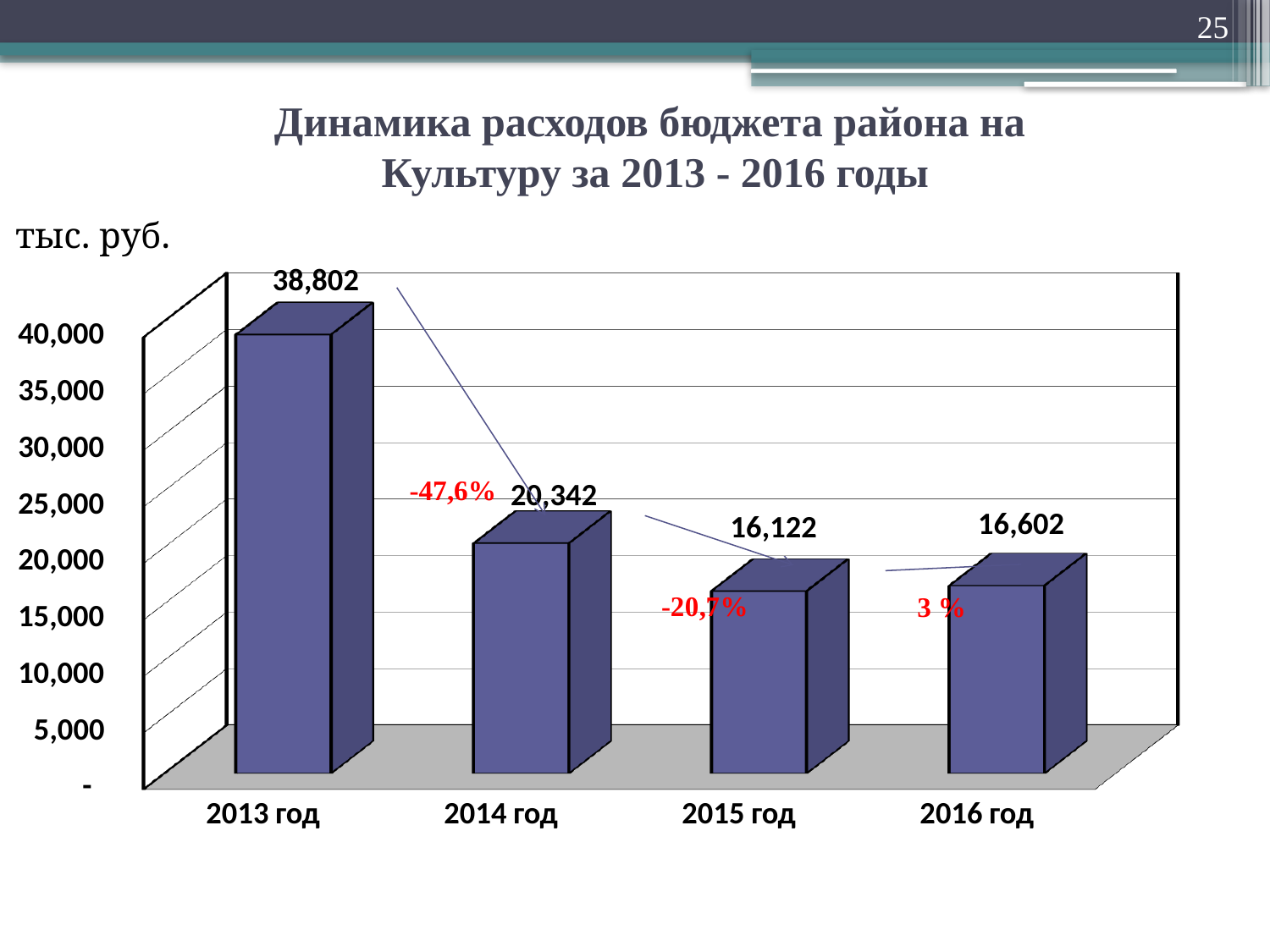
Which is larger, the value for 2014 год or the value for 2016 год? 2014 год What kind of chart is shown on the slide? bar chart What is the value for 2015 год? 16,122 What percentage change is shown in red between 2013 год and 2014 год? -47,6% What is the value for 2016 год? 16,602 What is the value for 2014 год? 20,342 Which year has the highest value? 2013 год How many years are shown on the chart? 4 Which year has the lowest value? 2015 год What is the difference between the values for 2016 год and 2015 год? 480 What is the value for 2013 год? 38,802 What is the difference between the values for 2013 год and 2014 год? 18,460